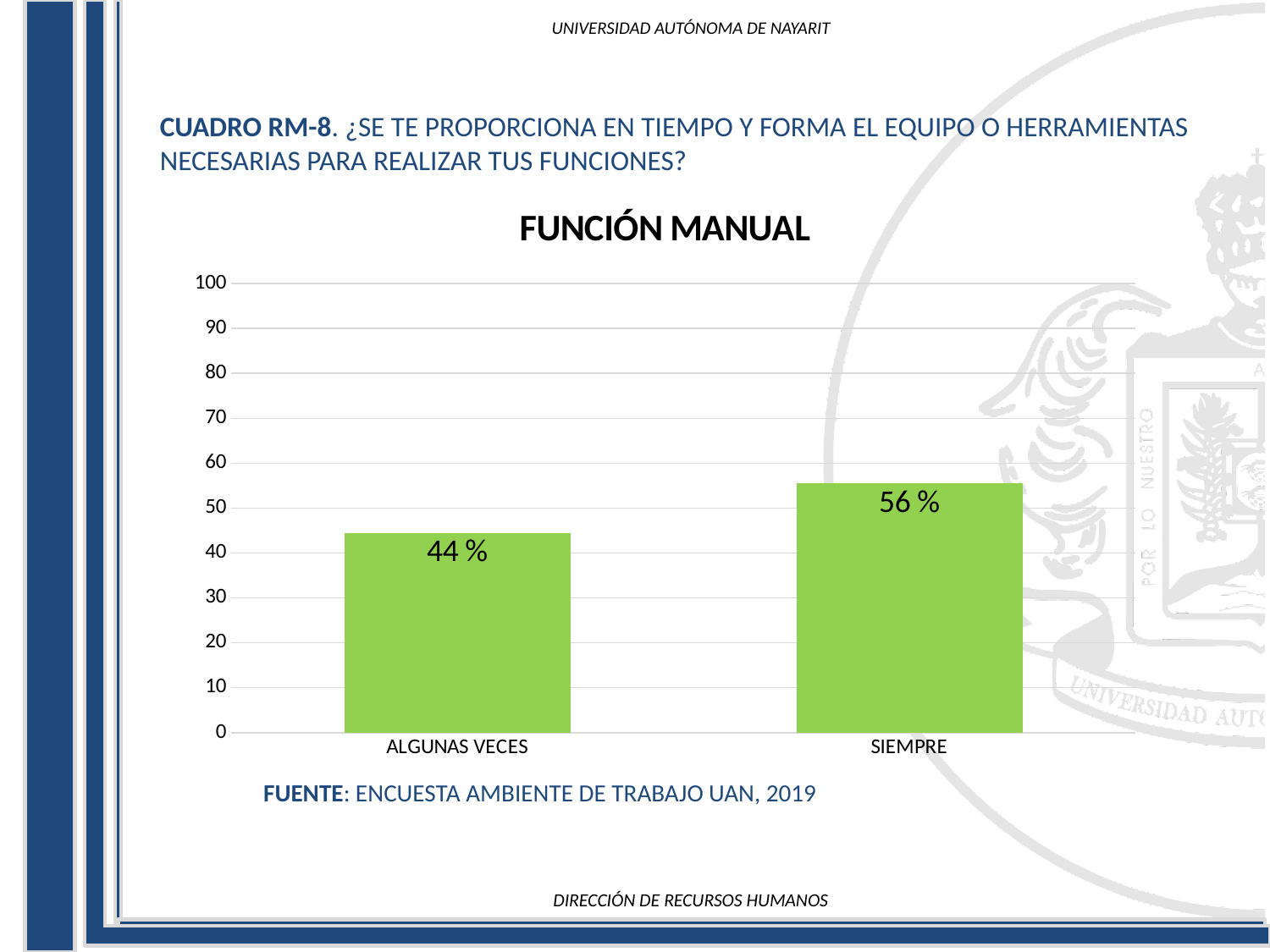
What colour are the bars in the chart? green Is the value for ALGUNAS VECES greater or less than 50? less How many categories are shown on the x axis? 2 What is the value for ALGUNAS VECES? 44 % Which category has the lowest value? ALGUNAS VECES What is the value for SIEMPRE? 56 % Which category has the highest value? SIEMPRE What kind of chart is shown on the slide? bar chart Is the value for SIEMPRE greater or less than 50? greater What is the title of the chart? FUNCIÓN MANUAL Which is larger, the value for ALGUNAS VECES or the value for SIEMPRE? SIEMPRE What is the difference between the values for SIEMPRE and ALGUNAS VECES? 12 %